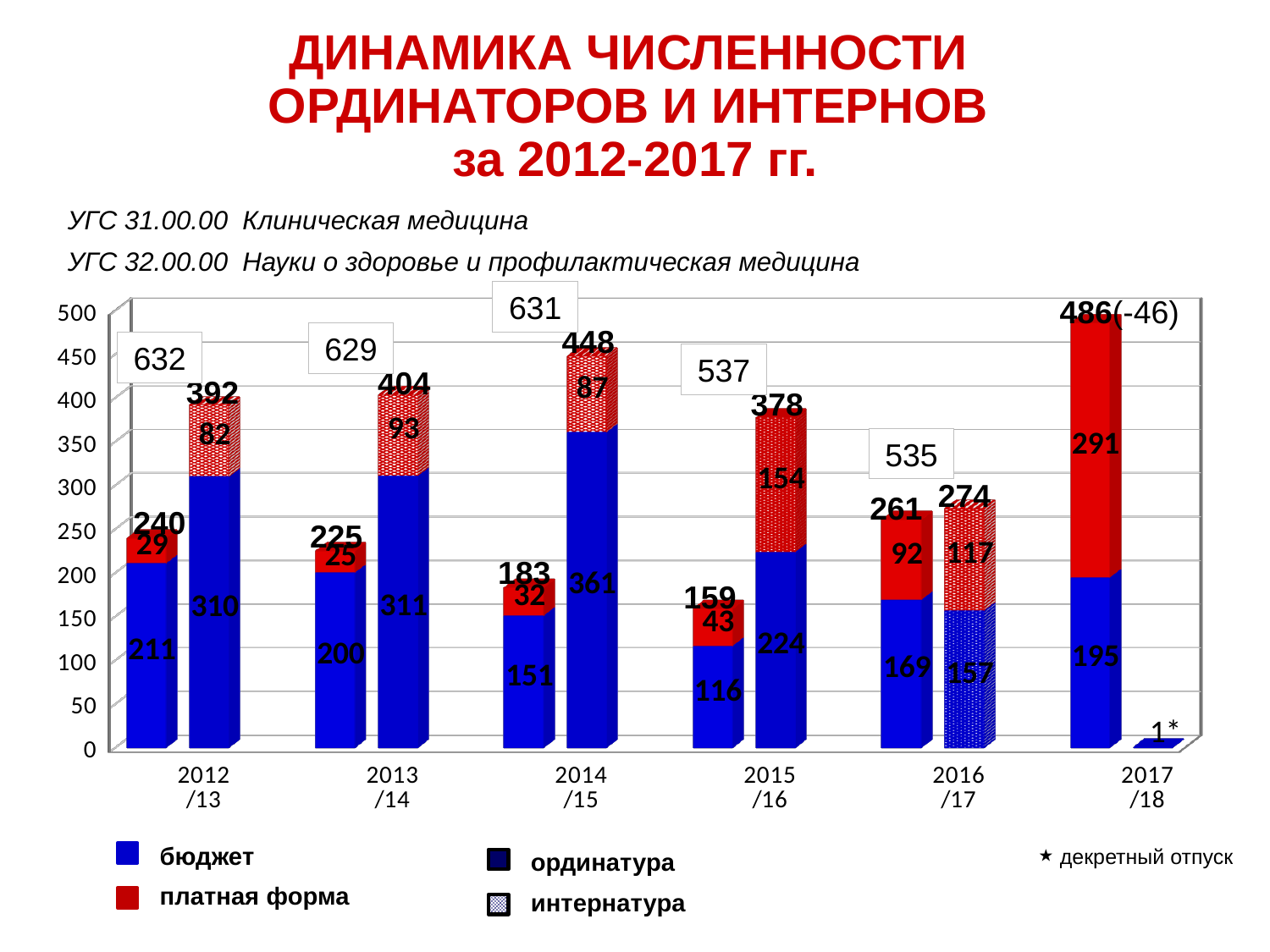
Which is larger: the bar labelled 448 for 2014/15 or the bar labelled 378 for 2015/16? 448 for 2014/15 What is the total of the bar for 2016/17 whose segments are 169 and 92? 261 How many year categories are shown on the x axis? 6 What is the total of the bar for 2013/14 whose segments are 311 and 93? 404 Which year's pair of bars has the highest combined total printed above it? 2012/13 What is the value of the blue (бюджет) segment in the bar labelled 361 for 2014/15? 361 What is the total printed above the pair of bars for 2012/13? 632 What is the value of the red (платная форма) segment in the bar labelled 486 for 2017/18? 291 What is the total printed above the pair of bars for 2015/16? 537 What type of chart is shown on the slide? stacked bar chart What is the difference between the combined totals for 2012/13 (632) and 2016/17 (535)? 97 What value is printed on the small bar for 2017/18 marked with an asterisk? 1